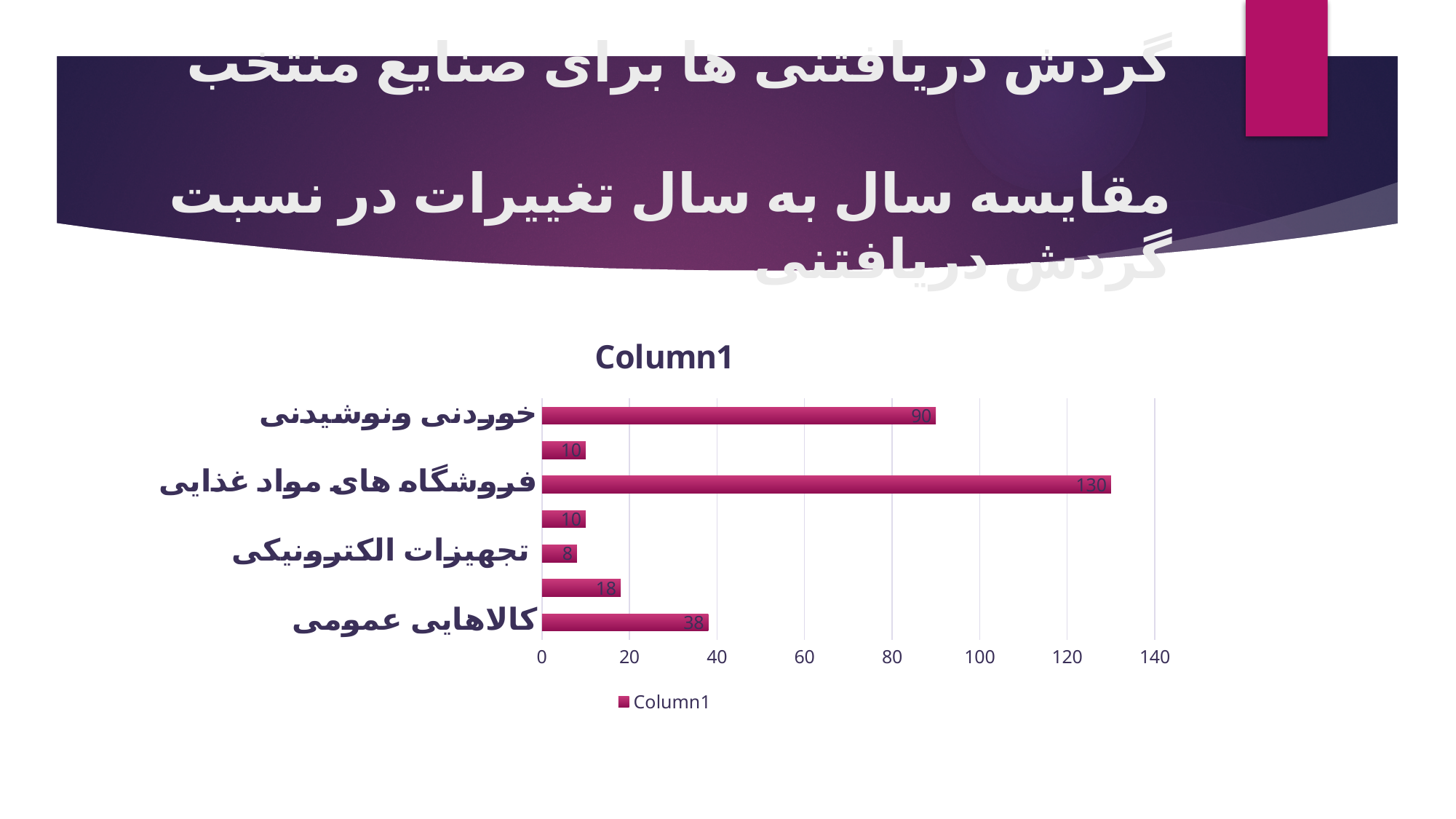
What is the value for فروشگاه های مواد غذایی? 130 What is the chart's title? Column1 Which category has the lowest value? تجهیزات الکترونیکی What is the value for تجهیزات الکترونیکی? 8 What is the value for کالاهایی عمومی? 38 How many series does the legend list? 1 What is the value for خوردنی ونوشیدنی? 90 Which category has the highest value? فروشگاه های مواد غذایی Which is larger, the value for کالاهایی عمومی or the value for تجهیزات الکترونیکی? کالاهایی عمومی How many bars are plotted in the chart? 7 What is the difference between the values for فروشگاه های مواد غذایی and خوردنی ونوشیدنی? 40 What kind of chart is shown on the slide? bar chart